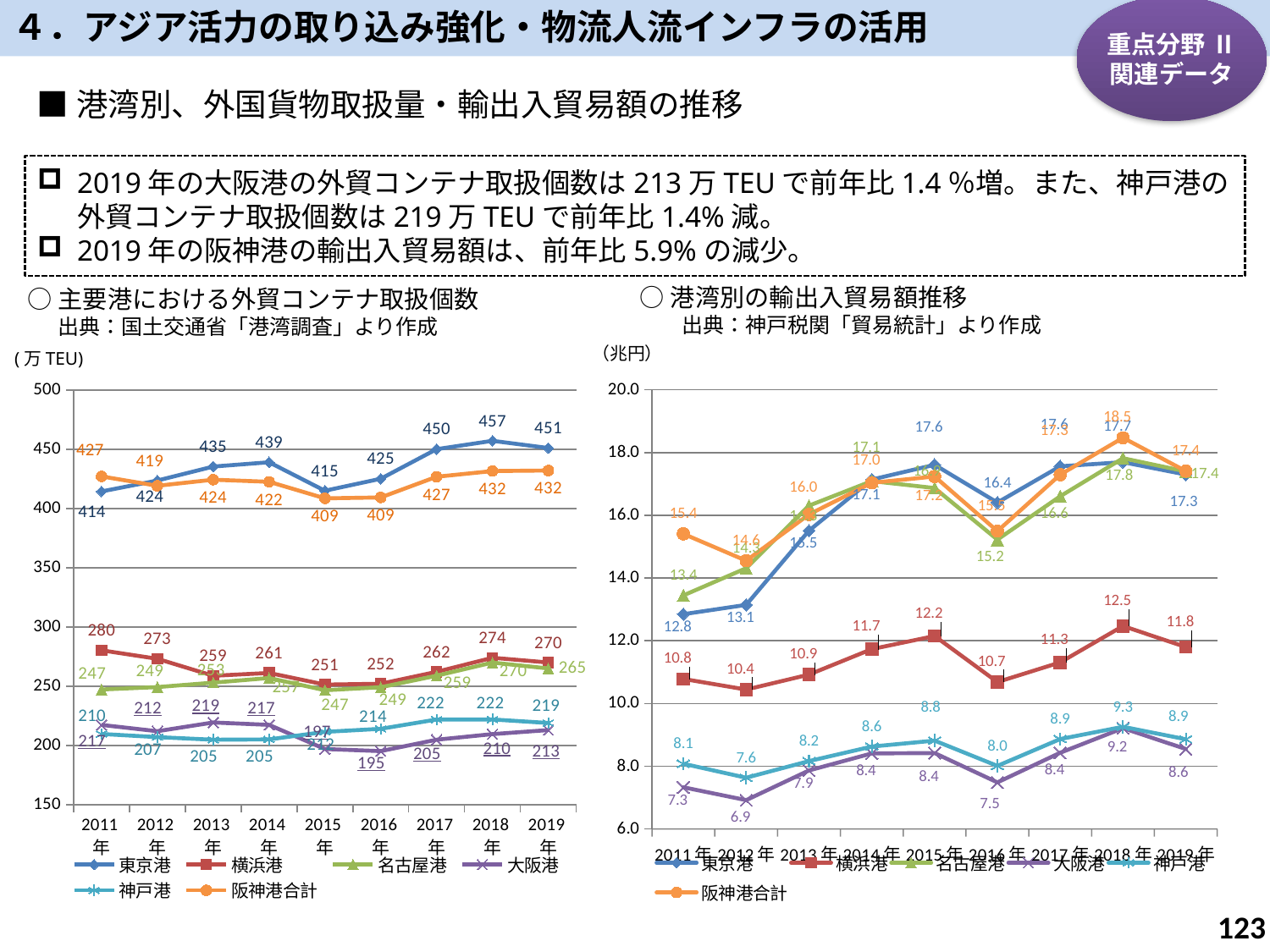
In the right chart (港湾別の輸出入貿易額推移), how many years are plotted on the x axis? 9 In the right chart (港湾別の輸出入貿易額推移), what is the value for 横浜港 in 2018年? 12.5 In the left chart (主要港における外貿コンテナ取扱個数), what is the value for 東京港 in 2018? 457 In the left chart (主要港における外貿コンテナ取扱個数), what is the value for 横浜港 in 2011? 280 In the left chart (主要港における外貿コンテナ取扱個数), which is larger in 2019, 神戸港 or 大阪港? 神戸港 In the right chart (港湾別の輸出入貿易額推移), what is the value for 大阪港 in 2012年? 6.9 In the right chart (港湾別の輸出入貿易額推移), what is the unit shown above the vertical axis? 兆円 In the left chart (主要港における外貿コンテナ取扱個数), what is the difference between 東京港 and 阪神港合計 in 2019? 19 What kind of chart is the right chart (港湾別の輸出入貿易額推移)? Line chart In the right chart (港湾別の輸出入貿易額推移), in which year is the 阪神港合計 value highest? 2018年 In the left chart (主要港における外貿コンテナ取扱個数), in which year is the 東京港 value highest? 2018年 In the left chart (主要港における外貿コンテナ取扱個数), how many series does the legend list? 6